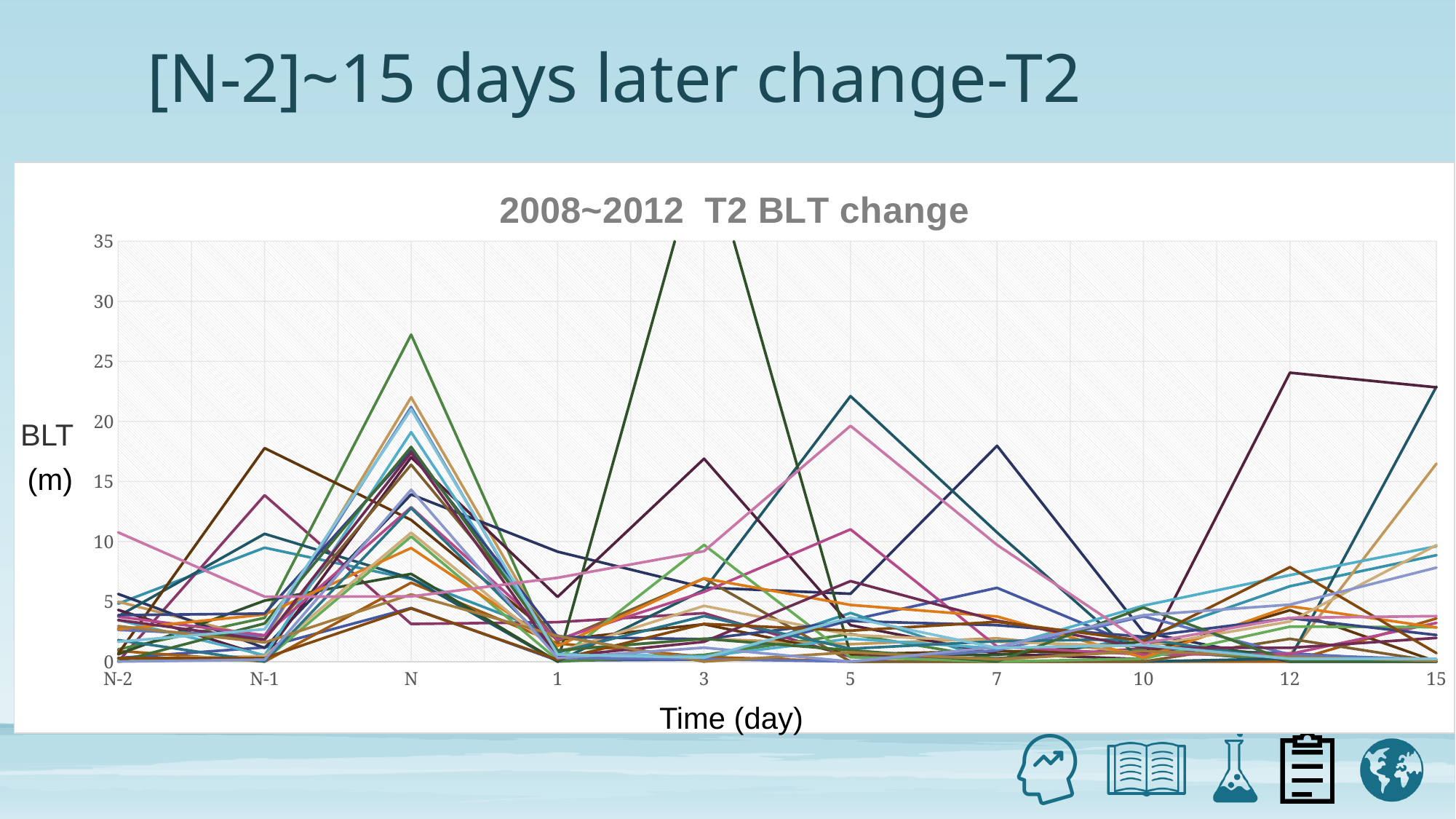
What is the first label on the x axis? N-2 What is the label of the y axis? BLT (m) What kind of chart is shown on the slide? line chart What is the last label on the x axis? 15 Is the highest value reached by any line at N greater or less than 25? greater What is the highest tick value shown on the y axis? 35 Is the highest value reached by any line at N-2 greater or less than 15? less Is the highest value reached by any line at day 12 greater or less than 20? greater How many points are labelled on the x axis of the chart? 10 What is the title of the chart? 2008~2012 T2 BLT change